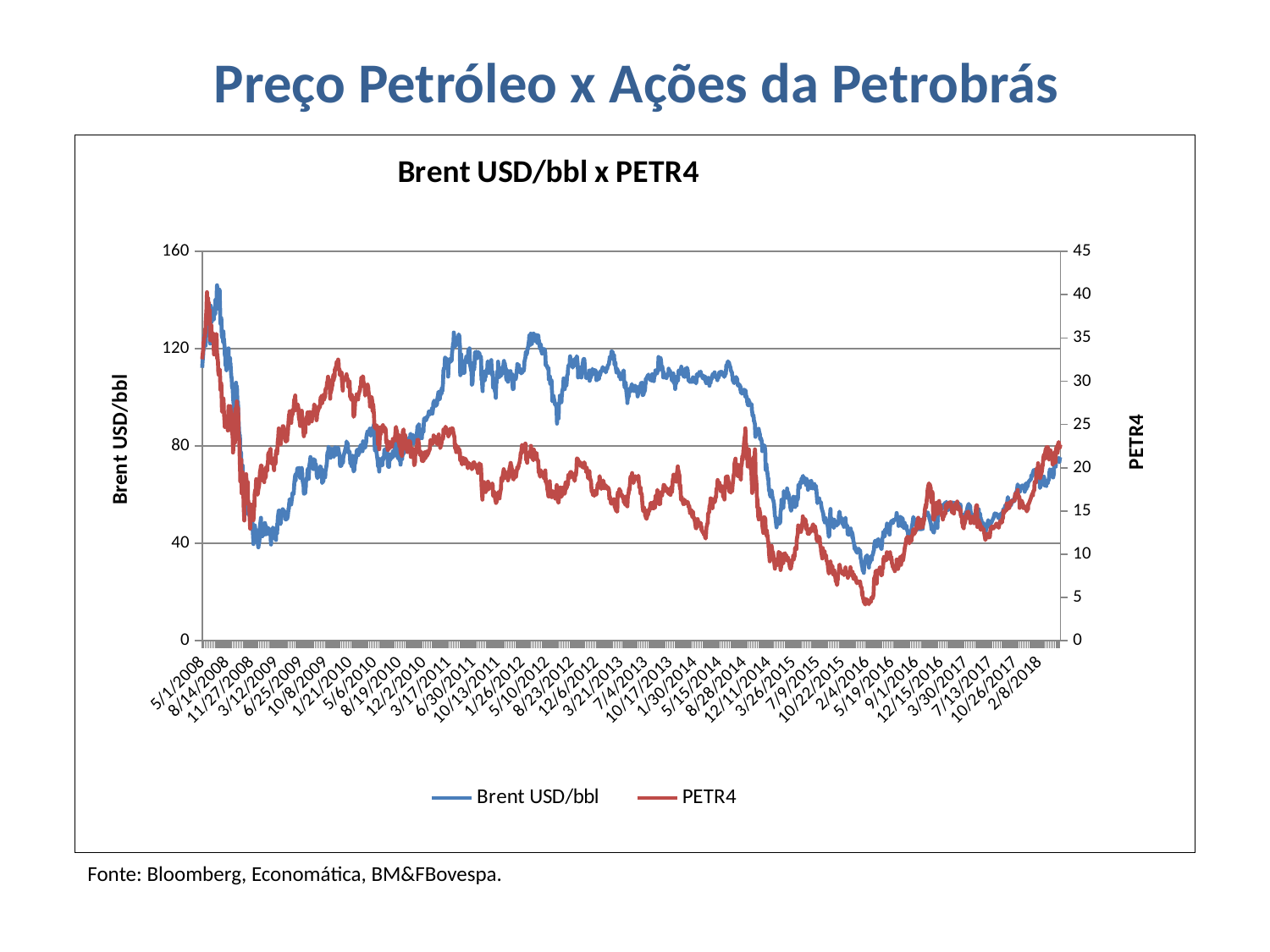
Is the peak value of Brent USD/bbl in mid-2008 greater or less than 120? greater Is the value of Brent USD/bbl around 2/4/2016 greater or less than 40? less Is the value of Brent USD/bbl around 6/30/2011 greater or less than 80? greater Which series is plotted against the right-hand axis? PETR4 What is the title of the chart? Brent USD/bbl x PETR4 What kind of chart is shown on the slide? Line chart How many series does the legend list? 2 Does the Brent USD/bbl series rise or fall overall between 5/19/2016 and 2/8/2018? rise Does the Brent USD/bbl series rise or fall between 8/28/2014 and 3/26/2015? fall Is the Brent USD/bbl value larger at 2/8/2018 or at 2/4/2016? 2/8/2018